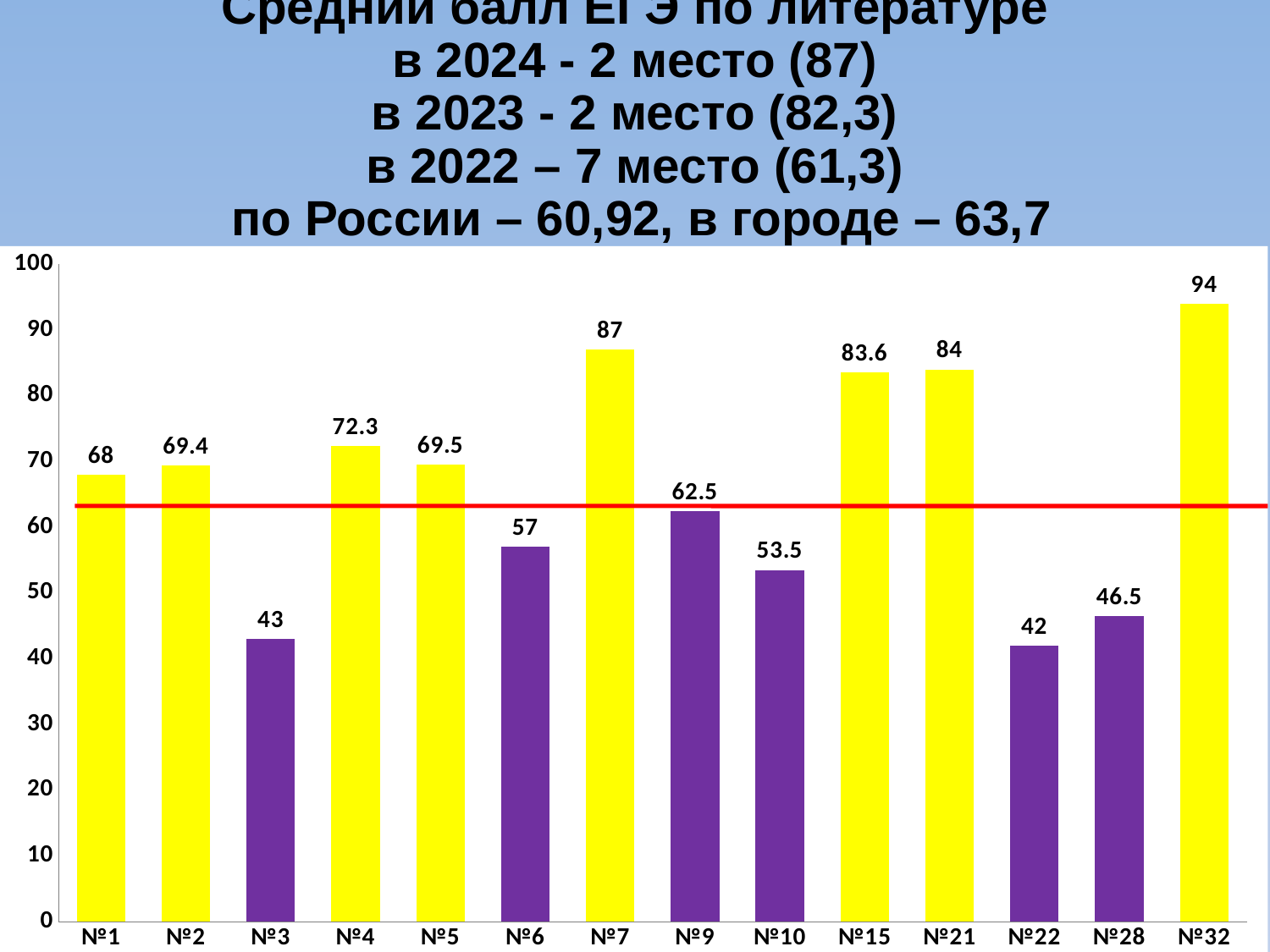
Which is larger, the value for №21 or the value for №15? №21 What is the value for №15? 83.6 Which category has the highest value? №32 What is the value for №7? 87 How many categories are shown on the x axis? 14 Which category has the lowest value? №22 What kind of chart is shown on the slide? bar chart What is the value for №28? 46.5 What is the difference between the values for №4 and №3? 29.3 What is the difference between the values for №32 and №7? 7 What colour are the bars whose values are below the red horizontal line? purple Which is larger, the value for №6 or the value for №9? №9